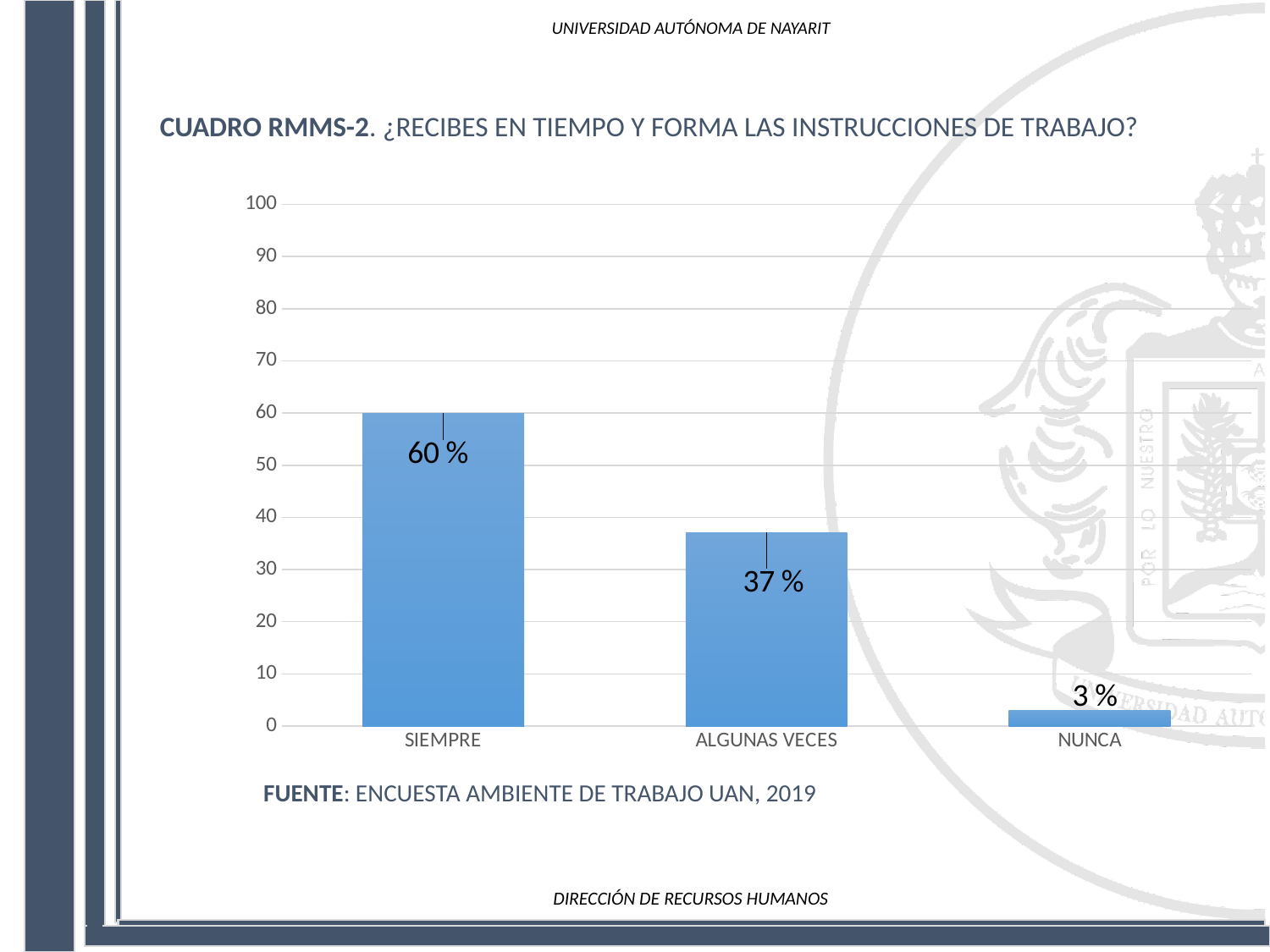
What is the value for NUNCA? 3 % What is the difference between the values for ALGUNAS VECES and NUNCA? 34 % What kind of chart is shown on the slide? bar chart What is the value for ALGUNAS VECES? 37 % Do the values rise or fall from left to right along the x axis? fall Which is larger, the value for ALGUNAS VECES or the value for NUNCA? ALGUNAS VECES What is the value for SIEMPRE? 60 % Which category has the lowest value? NUNCA Which category has the highest value? SIEMPRE How many categories are shown on the x axis? 3 What is the difference between the values for SIEMPRE and ALGUNAS VECES? 23 % Is the value for ALGUNAS VECES greater or less than 40? less